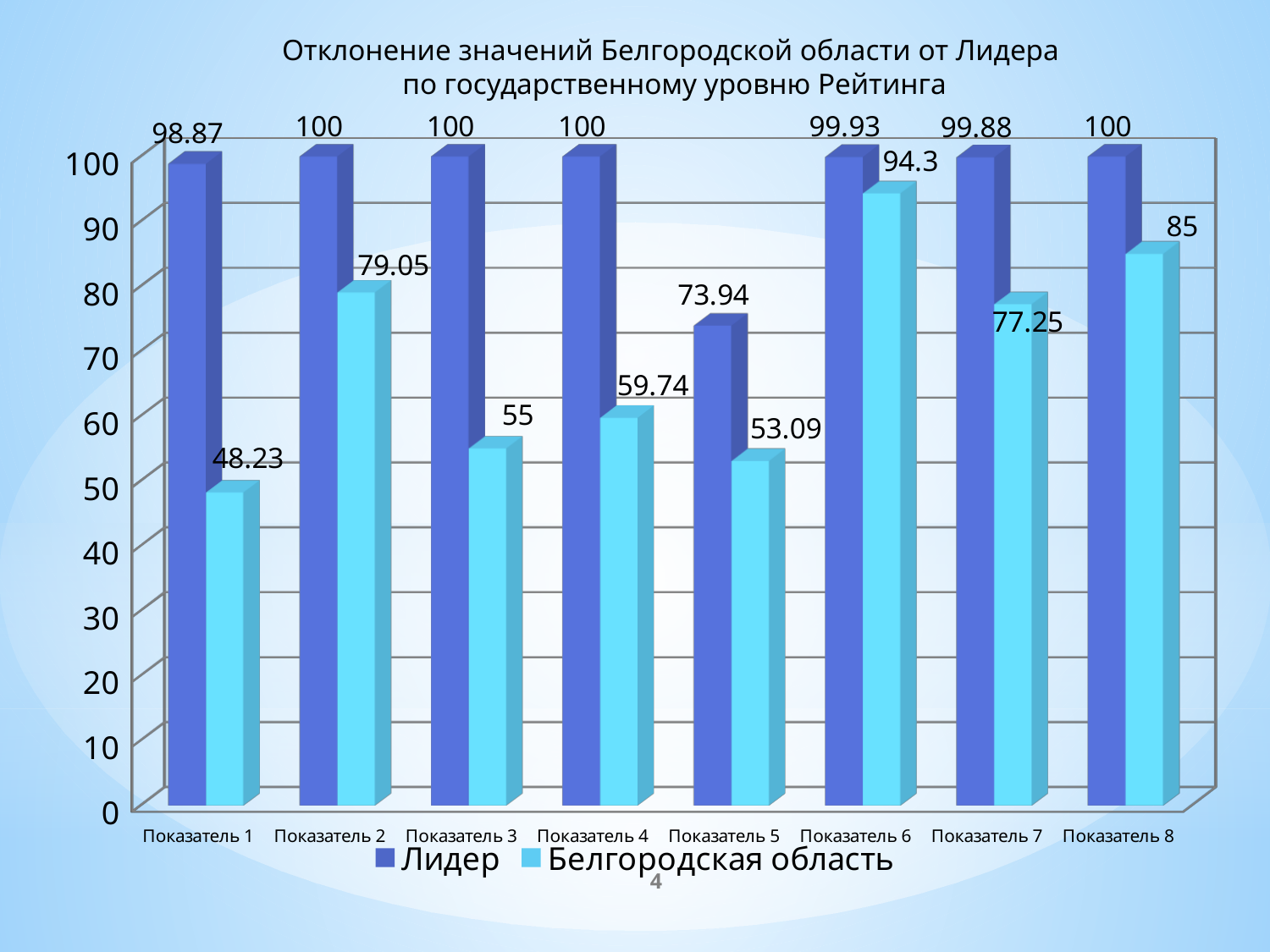
What is the difference between Лидер and Белгородская область for Показатель 8? 15 How many categories are shown on the x axis? 8 What is the value for Лидер for Показатель 5? 73.94 Which is larger for Показатель 2: the value for Лидер or for Белгородская область? Лидер What is the value for Белгородская область for Показатель 1? 48.23 How many series does the legend list? 2 What is the difference between Лидер and Белгородская область for Показатель 3? 45 What is the value for Белгородская область for Показатель 6? 94.3 Which category has the lowest value for Белгородская область? Показатель 1 Which category has the highest value for Белгородская область? Показатель 6 What kind of chart is shown on the slide? Bar chart Which category has the lowest value for Лидер? Показатель 5